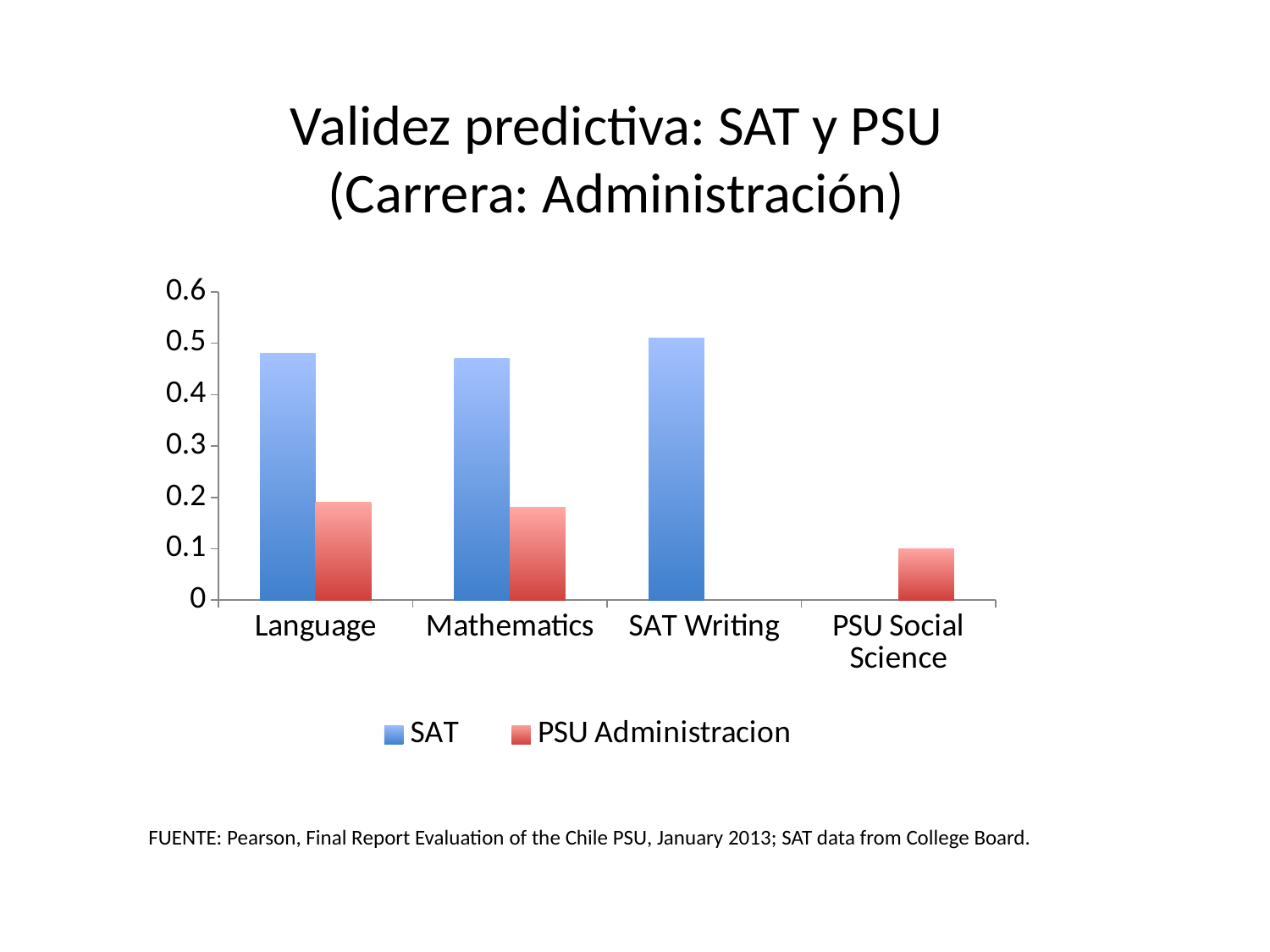
Which series does the red colour represent in the legend? PSU Administracion Which category has the lowest PSU Administracion value? PSU Social Science Is the PSU Administracion value for PSU Social Science greater or less than 0.2? less Is the SAT value for Language greater or less than 0.4? greater For Mathematics, which is larger: the SAT value or the PSU Administracion value? SAT Is the SAT value for Mathematics greater or less than 0.3? greater Which category has the highest SAT value? SAT Writing What kind of chart is shown on the slide? bar chart What is the title of the chart on the slide? Validez predictiva: SAT y PSU (Carrera: Administración) How many series does the legend list? 2 How many categories are shown on the x axis? 4